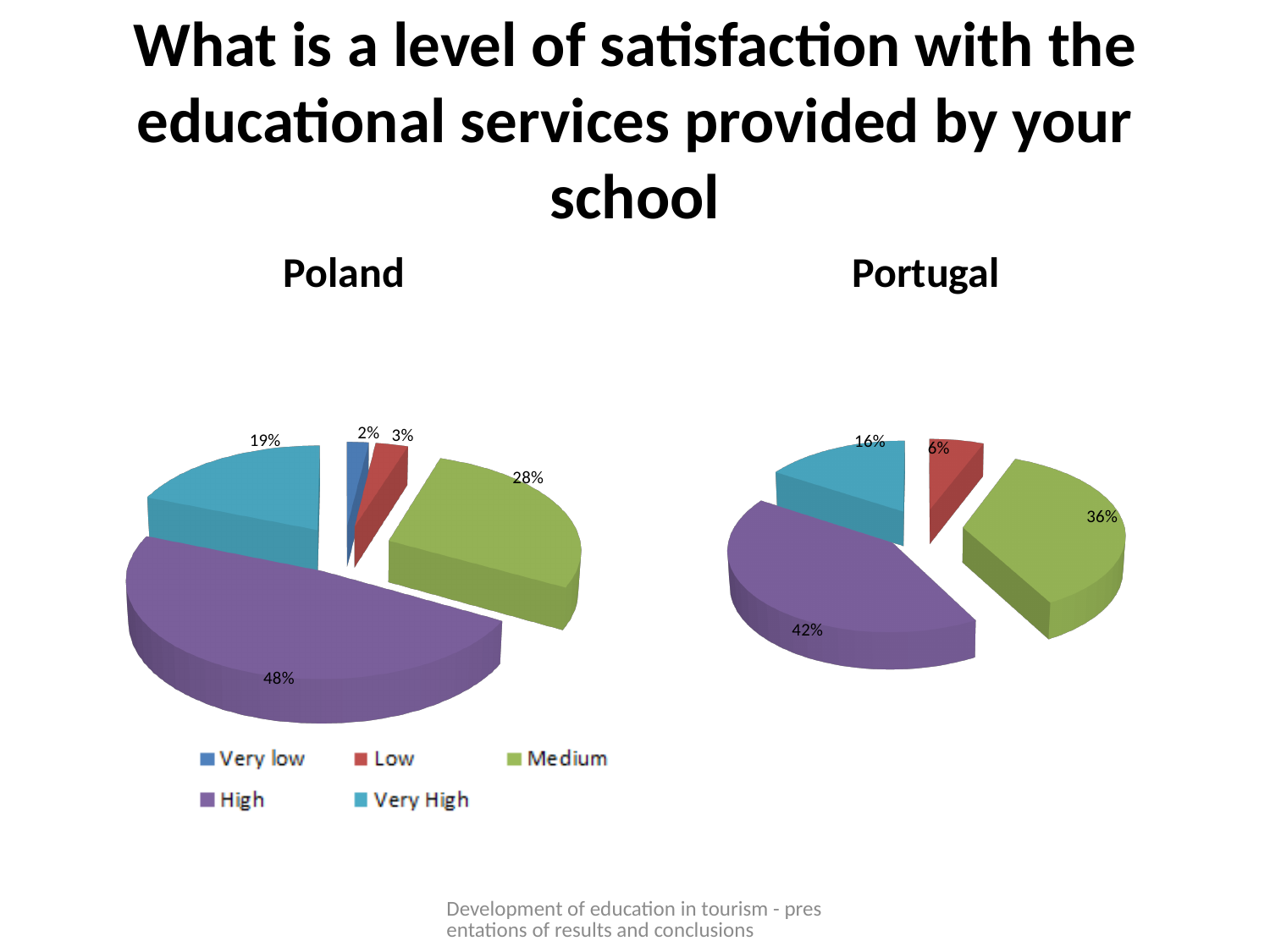
How many slices does the Portugal pie chart have? 4 In the Poland pie chart, what percentage is shown for Very High? 19% In the Poland pie chart, which category has the largest share? High In the Poland pie chart, which category has the smallest share? Very low In the Poland pie chart, what percentage is shown for High? 48% How many categories does the legend list? 5 In the Portugal pie chart, which category has the largest share? High Which is larger: the Medium share in Poland or the Medium share in Portugal? Portugal In the Portugal pie chart, what percentage is shown for Low? 6% What is the difference between the High share in Poland and the High share in Portugal? 6% In the Portugal pie chart, what percentage is shown for Medium? 36% What type of chart is used for Poland and Portugal? Pie chart